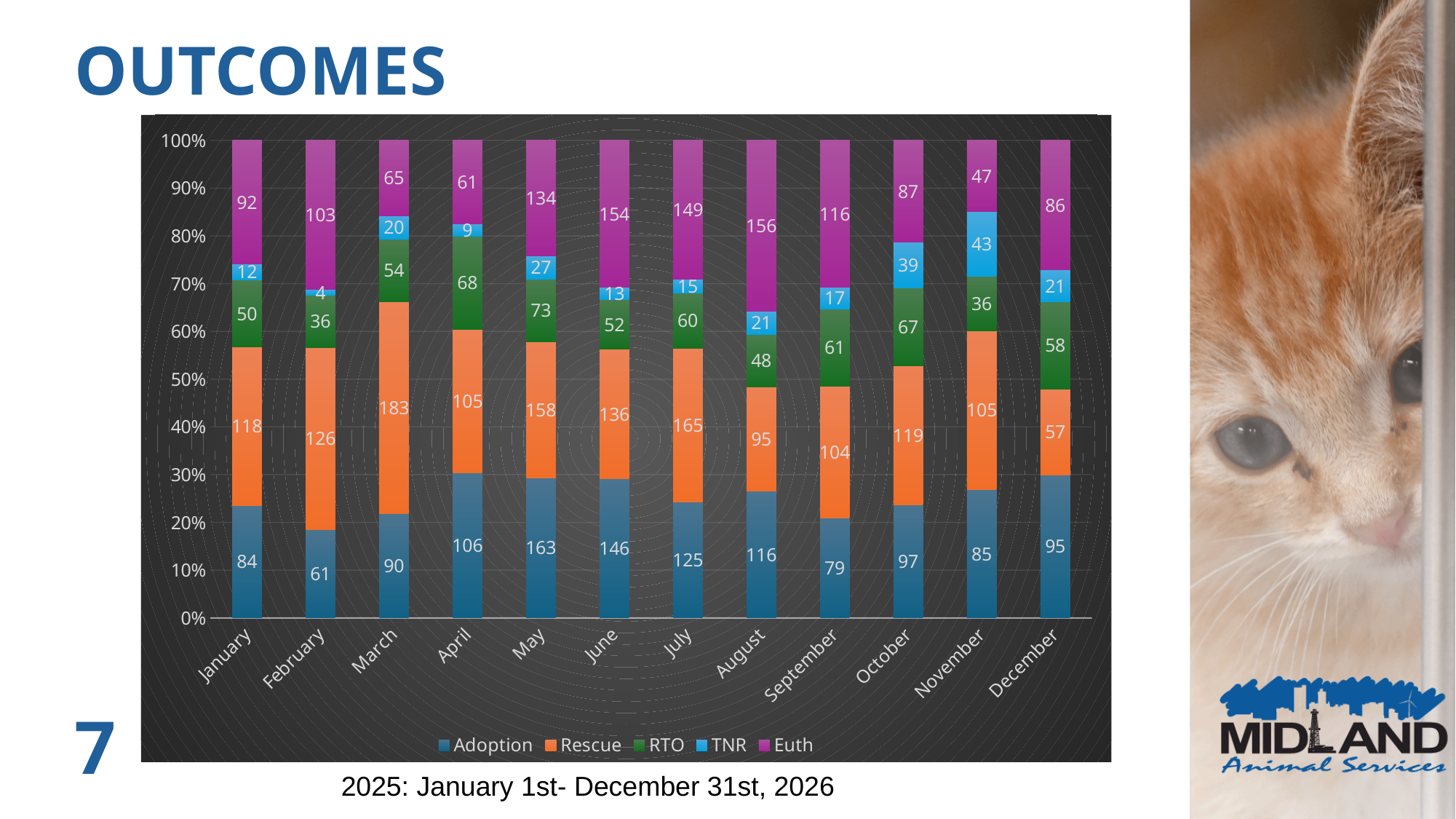
Which is larger, the RTO value for April or the RTO value for September? April How many months are shown on the x axis? 12 What is the total of all series for January? 356 What kind of chart is shown on the slide? Stacked bar chart Which month has the highest Adoption value? May What is the Euth value for August? 156 Which month has the lowest TNR value? February What is the Adoption value for May? 163 What is the Rescue value for March? 183 What is the difference between the Rescue values for July and December? 108 How many series does the legend list? 5 What is the TNR value for November? 43